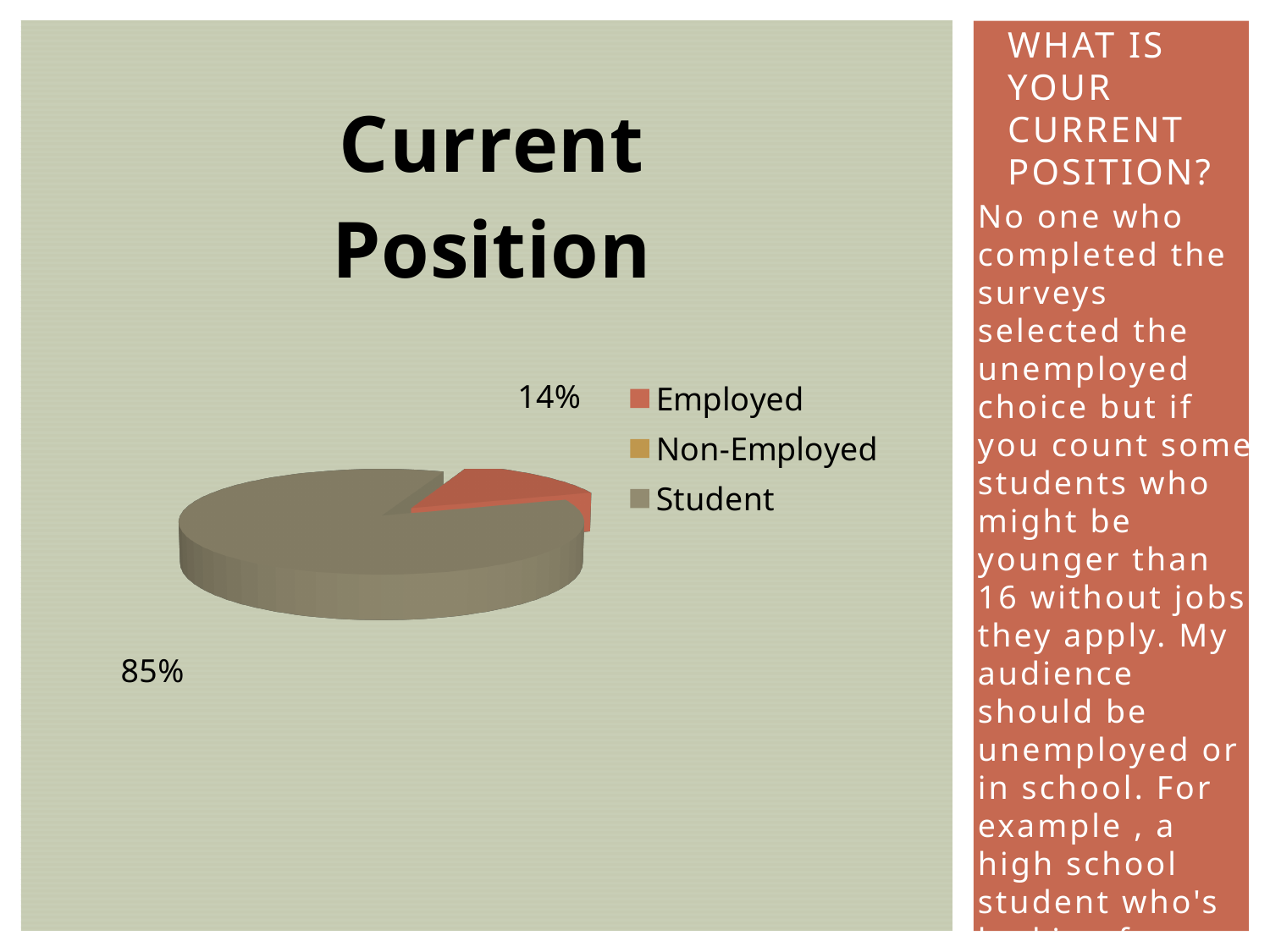
What kind of chart is shown on the slide? Pie chart What is the difference in percentage points between the Student slice and the Employed slice? 71 What share of the pie does the Student slice represent? 85% What percentage of the pie is labelled for Student? 85% Which is larger, the Student slice or the Employed slice? Student Which legend entry is shown in red? Employed What is the title of the chart? Current Position Which category has the largest slice of the pie? Student How many entries does the chart's legend list? 3 Of the two labelled slices, which has the smaller share? Employed What percentage of the pie is labelled for Employed? 14%